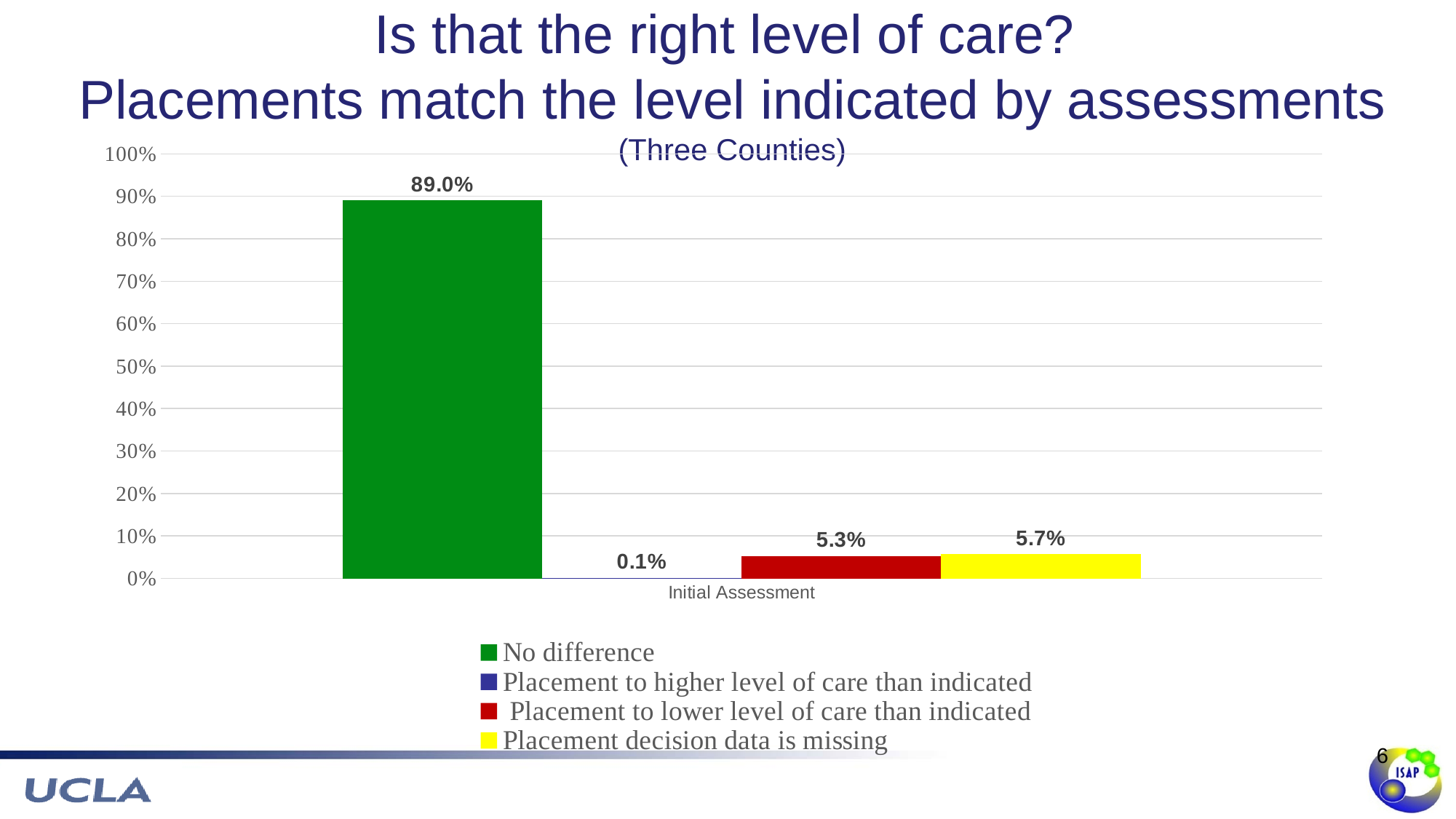
Which is larger: Placement to lower level of care than indicated or Placement decision data is missing? Placement decision data is missing What is the category label on the x axis? Initial Assessment What kind of chart is shown? Bar chart What is the difference between the No difference value and the Placement decision data is missing value? 83.3% What is the value for Placement to lower level of care than indicated? 5.3% What colour is the bar for Placement decision data is missing? Yellow What is the value for Placement to higher level of care than indicated? 0.1% Which series has the lowest value? Placement to higher level of care than indicated Which series has the highest value? No difference What is the value for Placement decision data is missing? 5.7% What is the value for No difference? 89.0% How many series does the legend list? 4